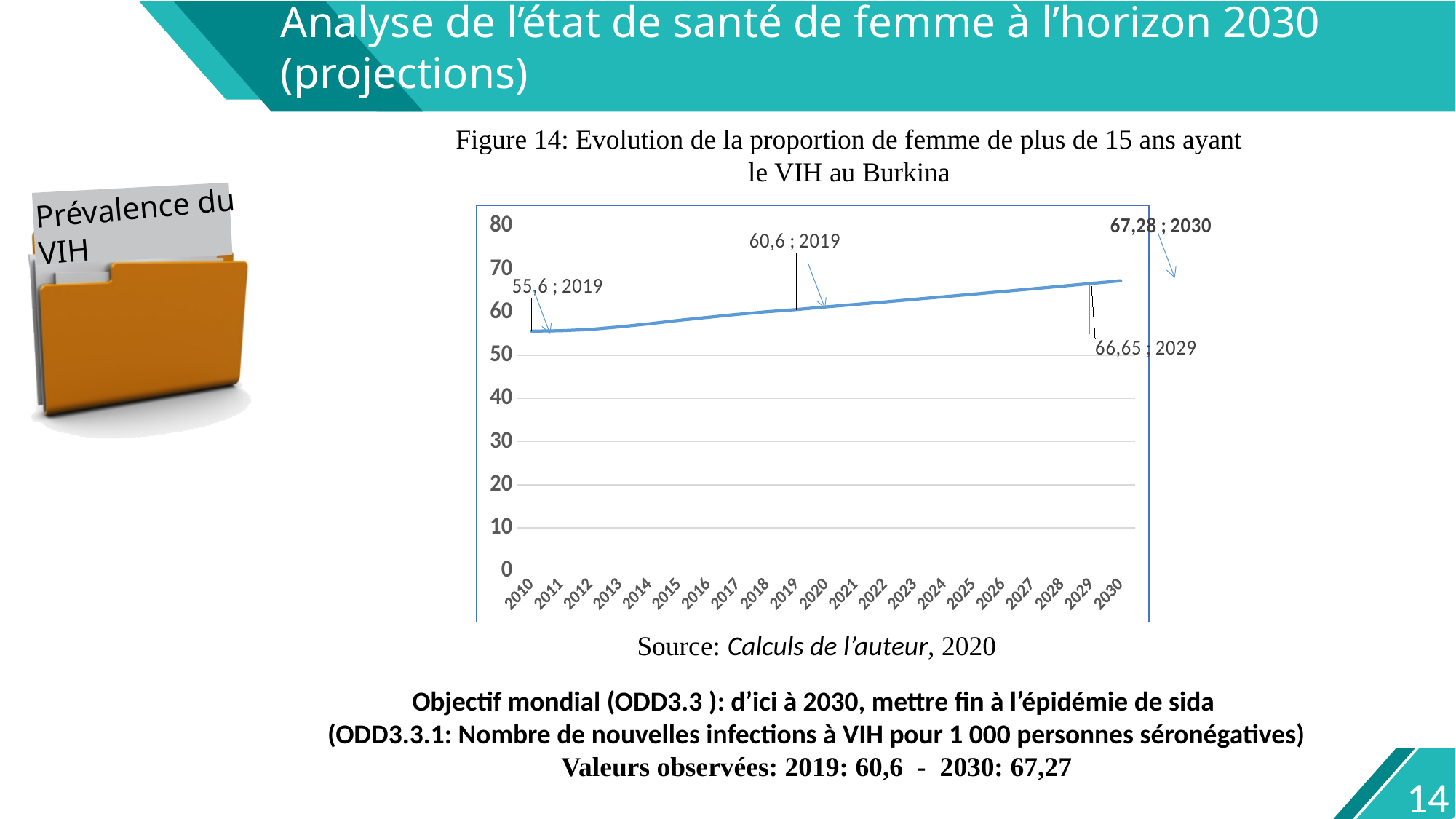
Is the value for 2015 greater or less than 50? greater Which is larger, the value for 2019 or the value for 2029? 2029 How many years are plotted along the x axis of the chart? 21 What is the value shown for 2029 on the chart? 66,65 What is the value labelled for 2019 on the chart? 60,6 Does the line rise or fall from 2010 to 2030? rise Which year has the highest value on the chart? 2030 Is the value for 2025 greater or less than 70? less What is the difference between the values for 2030 and 2029? 0,63 What is the value shown for 2030 on the chart? 67,28 What kind of chart is shown in Figure 14? line chart What is the difference between the values for 2030 and 2019? 6,68